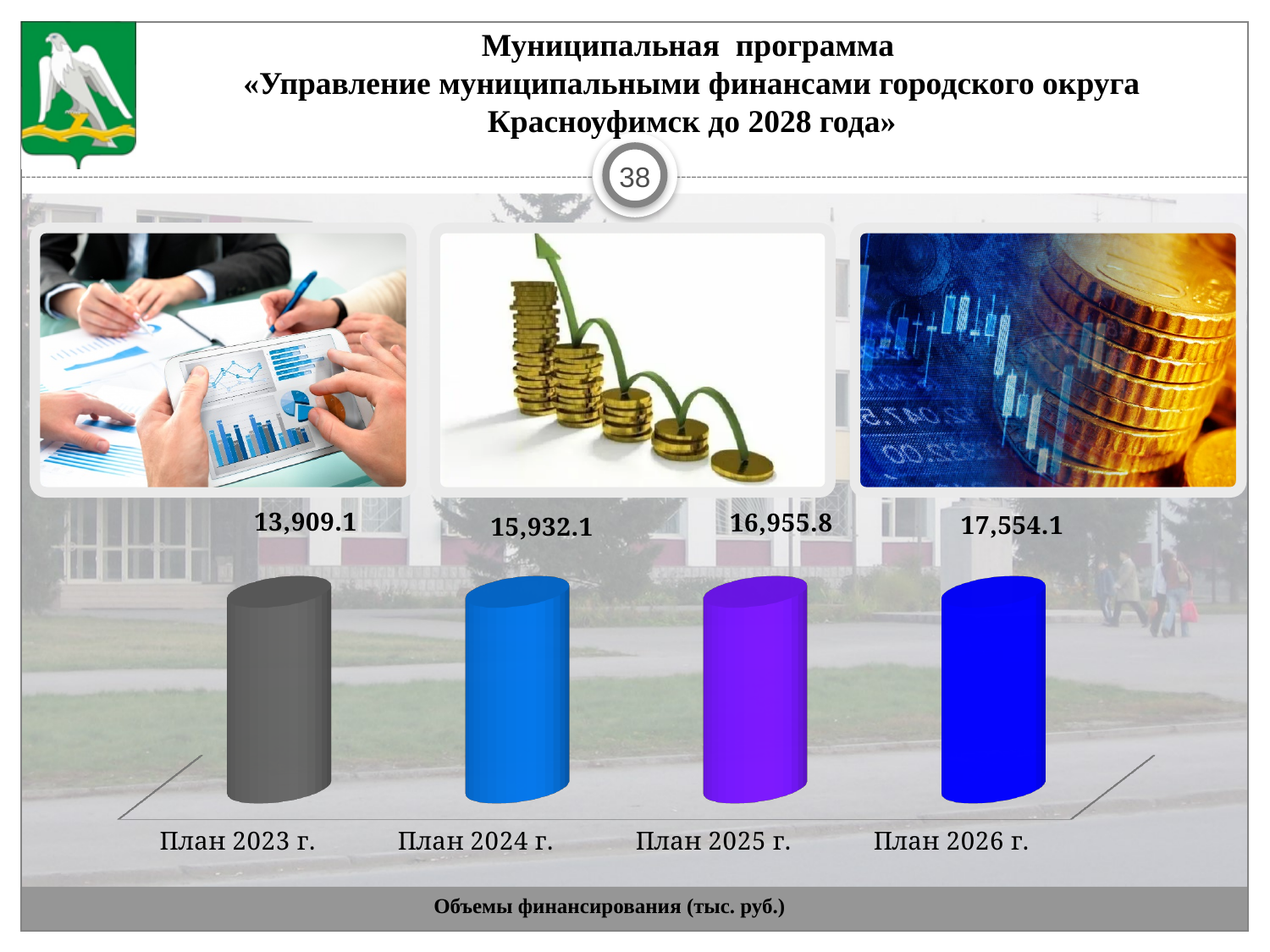
What is the difference between the values for План 2025 г. and План 2024 г.? 1,023.7 What is the difference between the values for План 2026 г. and План 2023 г.? 3,645.0 Do the values rise or fall from План 2023 г. to План 2026 г.? Rise What is the value for План 2024 г.? 15,932.1 Which category has the lowest value? План 2023 г. What is the value for План 2026 г.? 17,554.1 Which category has the highest value? План 2026 г. What is the value for План 2025 г.? 16,955.8 How many categories are shown in the chart? 4 What kind of chart is shown on the slide? Bar chart Which is larger, the value for План 2024 г. or the value for План 2025 г.? План 2025 г. What is the value for План 2023 г.? 13,909.1